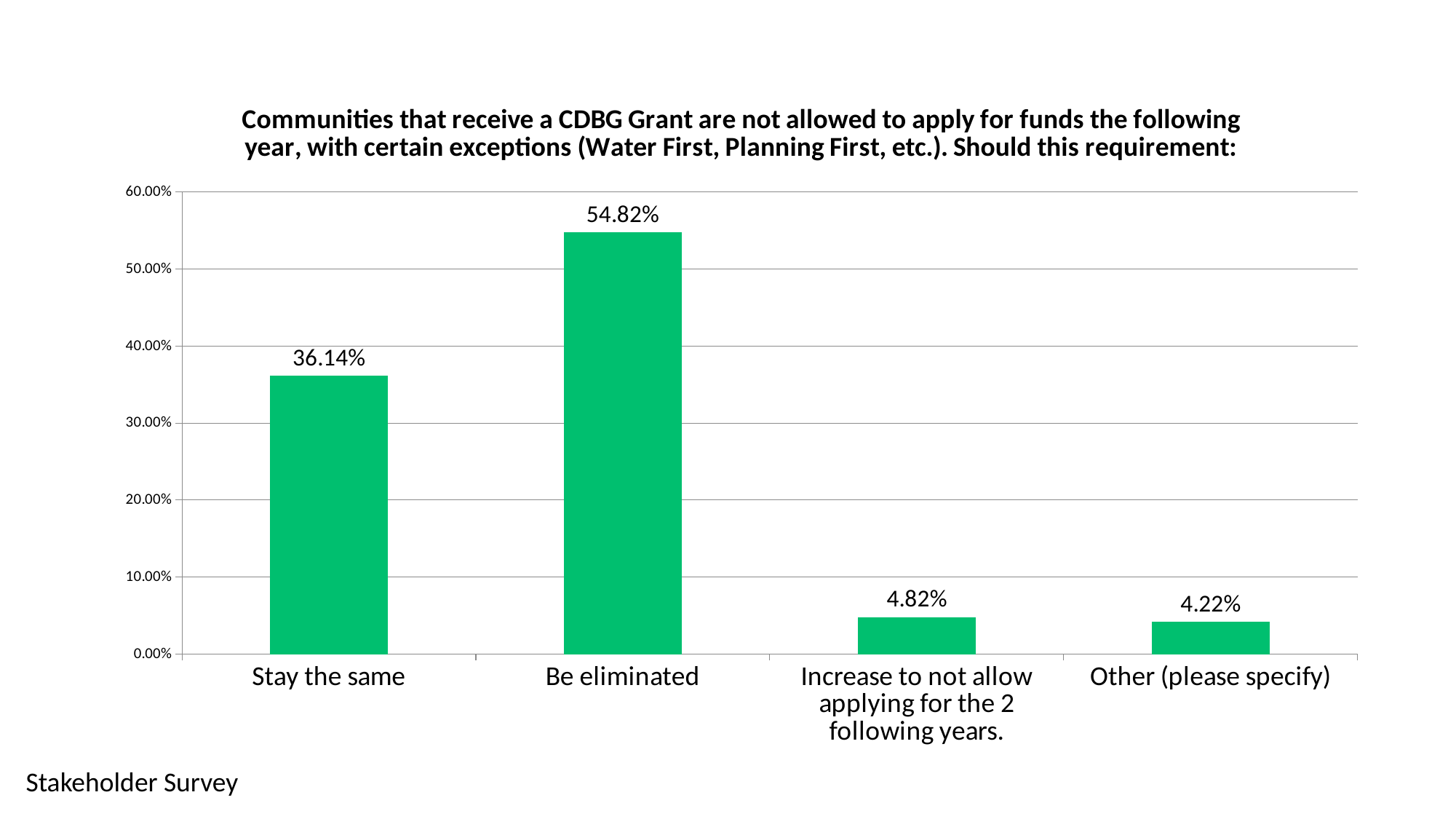
What is the source label shown at the bottom left of the slide? Stakeholder Survey Which is larger, the value for "Stay the same" or the value for "Be eliminated"? Be eliminated Which response option has the lowest percentage? Other (please specify) Is the value for "Stay the same" greater or less than 40.00%? less How many response options are shown on the chart? 4 What is the difference in percentage points between "Be eliminated" and "Stay the same"? 18.68 Which response option has the highest percentage? Be eliminated What is the value for "Increase to not allow applying for the 2 following years."? 4.82% What is the value for "Other (please specify)"? 4.22% What percentage of respondents chose "Be eliminated"? 54.82% What kind of chart is shown on the slide? Bar chart What percentage of respondents chose "Stay the same"? 36.14%